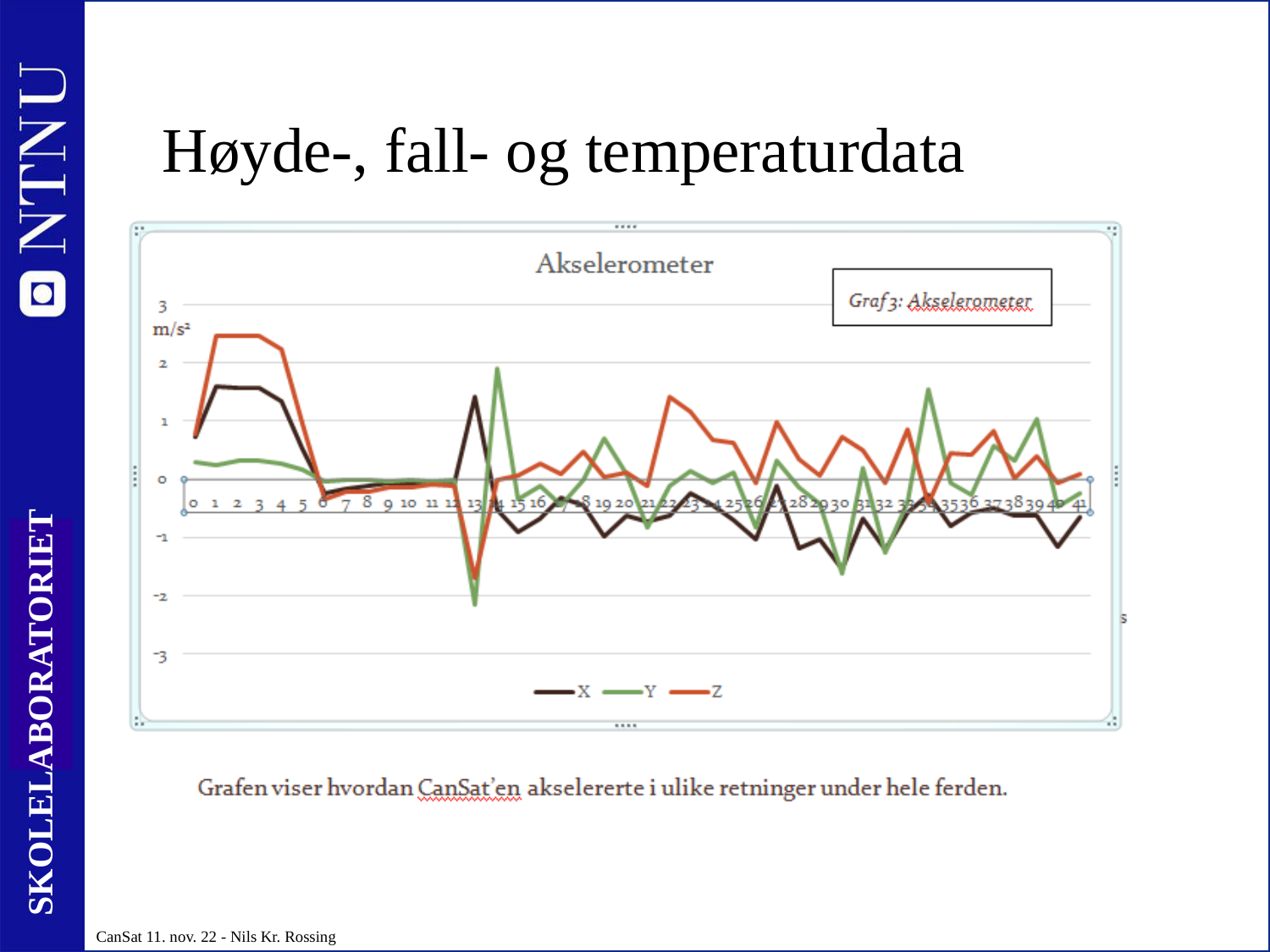
What are the series names in the legend of the Akselerometer chart? X, Y, Z Is the value of series Z at x = 2 greater or less than 2? greater How many series does the legend of the Akselerometer chart list? 3 What kind of chart is shown on the slide? line chart Is the value of series Z at x = 22 greater or less than 1? greater At x = 2, which series has the larger value, X or Z? Z What is the title of the chart? Akselerometer Is the value of series X at x = 30 greater or less than -1? less At x = 13, which series has the larger value, X or Y? X How many points are plotted along the x axis of the Akselerometer chart (from 0 to 41)? 42 Which series reaches the lowest value anywhere on the Akselerometer chart? Y